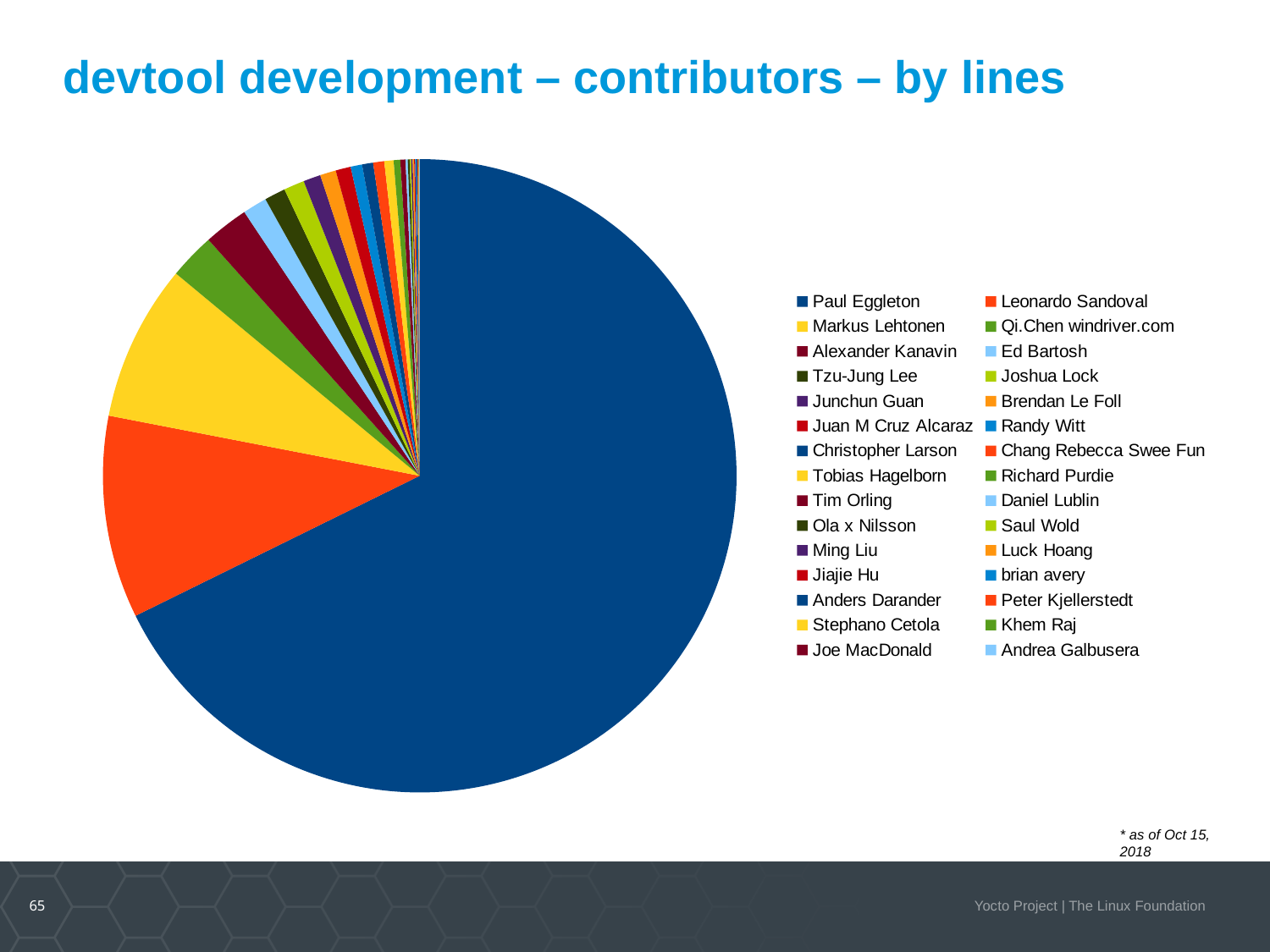
Which slice is larger, Leonardo Sandoval or Alexander Kanavin? Leonardo Sandoval Which slice is larger, Paul Eggleton or Leonardo Sandoval? Paul Eggleton What colour is the slice for Paul Eggleton? dark blue What is the title of the slide? devtool development – contributors – by lines Which slice is larger, Leonardo Sandoval or Markus Lehtonen? Leonardo Sandoval Which contributor has the largest slice of the pie? Paul Eggleton What kind of chart is shown on the slide? pie chart How many contributors are listed in the legend? 30